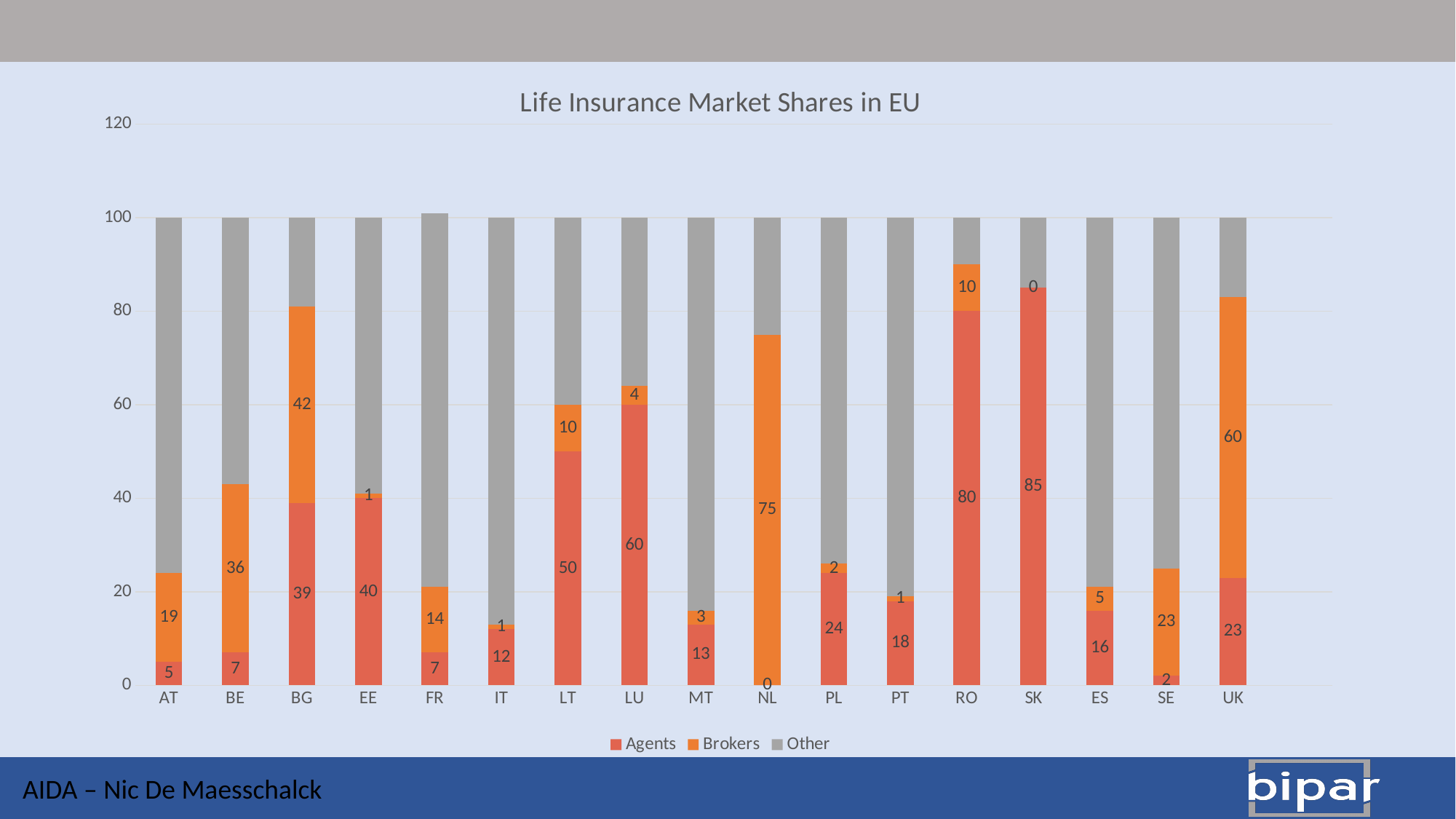
What kind of chart is shown on the slide? Stacked bar chart Which country has the highest Agents value? SK Which country has the highest Brokers value? NL How many countries are shown on the x axis? 17 What is the Brokers value for NL? 75 Which country has the lowest Agents value? NL What is the Brokers value for UK? 60 How many series does the legend list? 3 What is the Agents value for RO? 80 What is the difference between the Agents values for SK and RO? 5 Which has the larger Brokers value, BG or BE? BG What colour represents the Other series in the legend? Grey